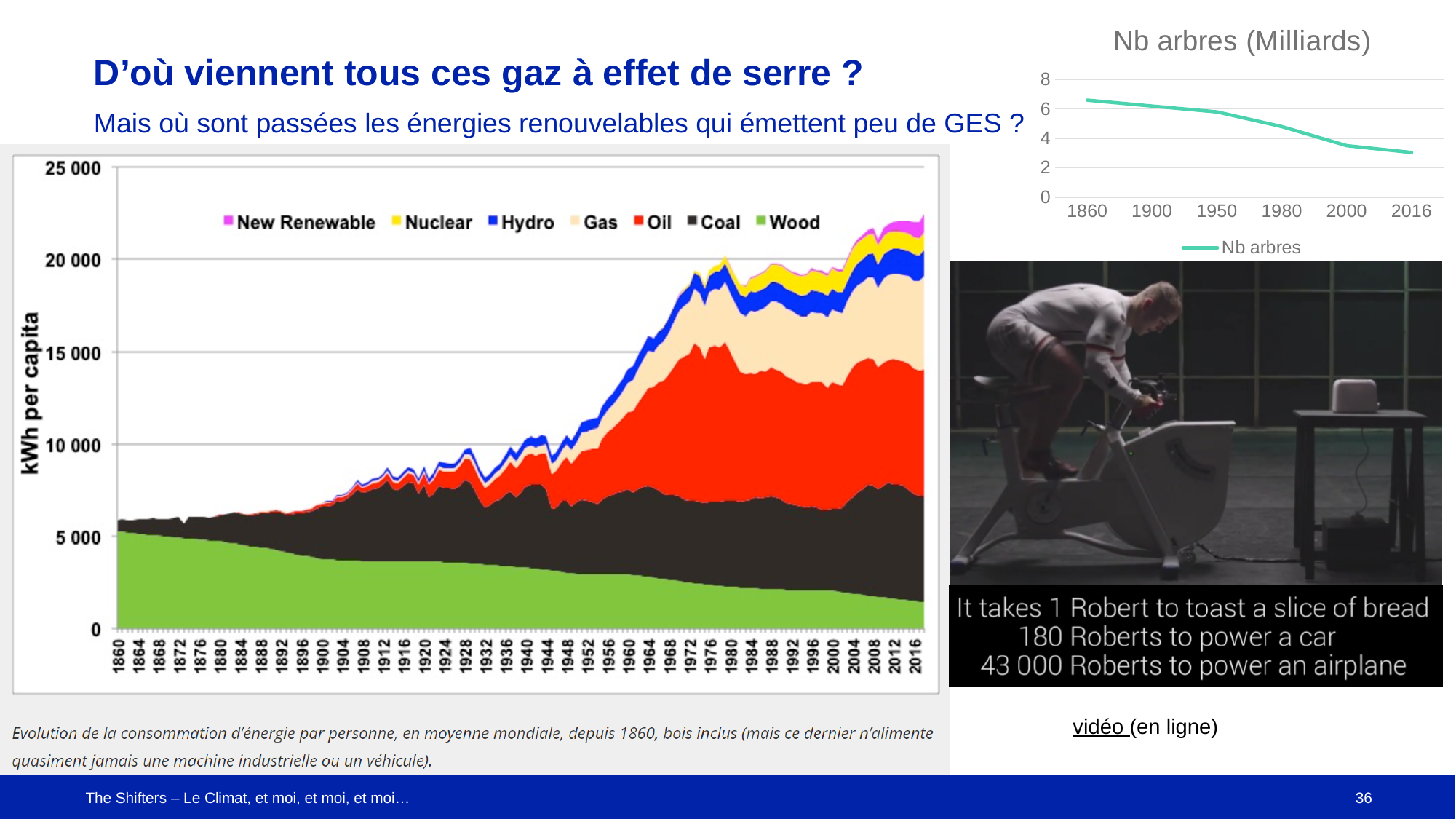
In the energy consumption chart on the left, is the total value for 2016 greater or less than 20 000 kWh per capita? greater How many series does the legend of the energy consumption chart on the left list? 7 In the 'Nb arbres (Milliards)' chart, which year has the lowest value? 2016 In the 'Nb arbres (Milliards)' chart, is the value for 1860 greater or less than 6? greater In the 'Nb arbres (Milliards)' chart, which year has the highest value? 1860 How many series does the legend of the 'Nb arbres (Milliards)' chart list? 1 In the 'Nb arbres (Milliards)' chart, is the value for 2016 greater or less than 4? less What kind of chart is the 'Nb arbres (Milliards)' chart at the top right of the slide? line chart What is the y-axis label of the energy consumption chart on the left of the slide? kWh per capita In the 'Nb arbres (Milliards)' chart, do the values rise or fall from 1860 to 2016? fall What kind of chart is the energy consumption chart on the left of the slide? stacked area chart In the 'Nb arbres (Milliards)' chart, how many years are labelled on the x axis? 6